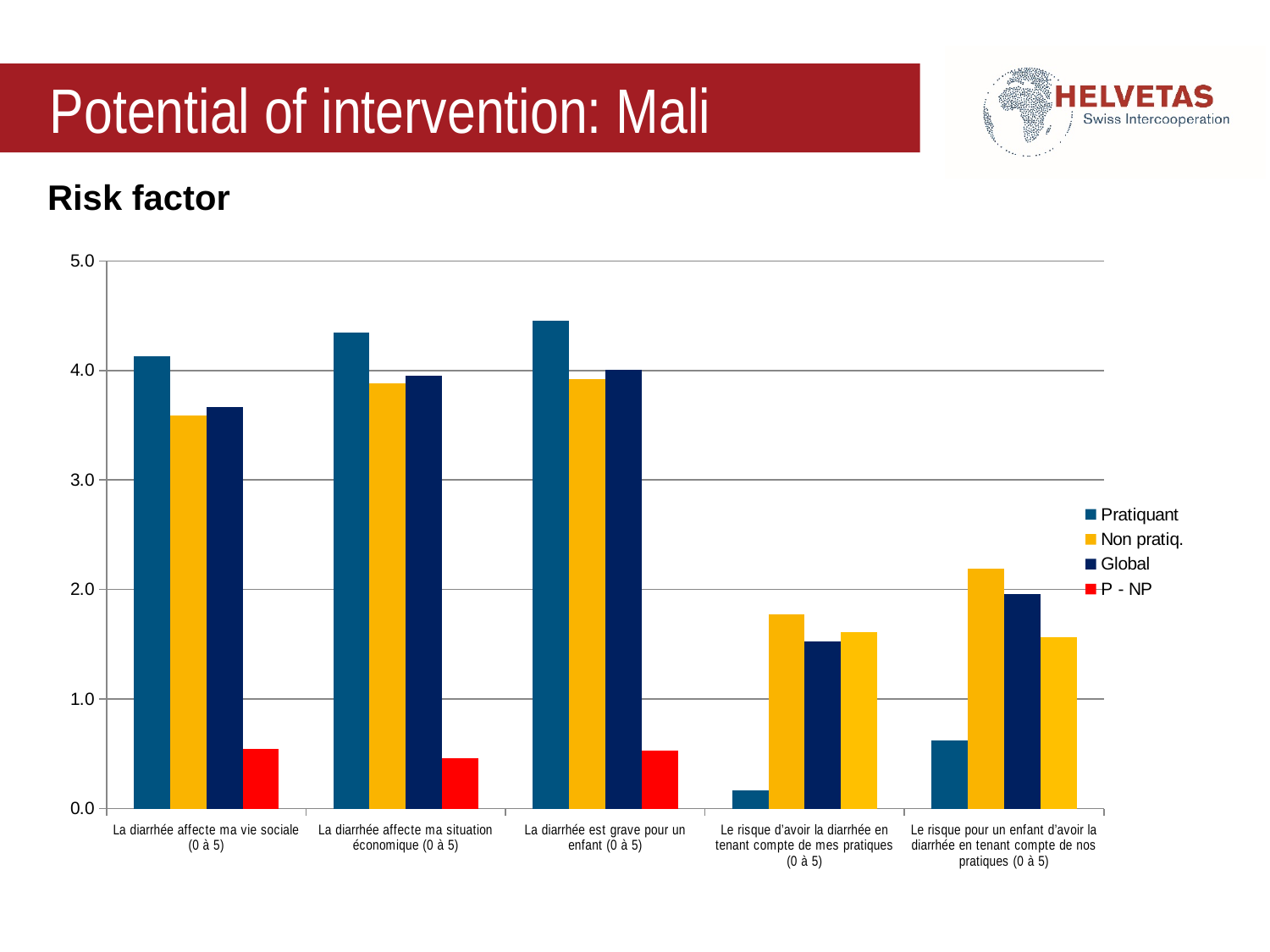
What heading appears above the chart? Risk factor Is the Pratiquant value for "Le risque d'avoir la diarrhée en tenant compte de mes pratiques (0 à 5)" greater or less than 1.0? less For "La diarrhée affecte ma vie sociale (0 à 5)", which is larger: Pratiquant or Non pratiq.? Pratiquant How many categories are shown along the x axis? 5 What colour is used for the P - NP series in the legend? red For "Le risque pour un enfant d'avoir la diarrhée en tenant compte de nos pratiques (0 à 5)", which is larger: Pratiquant or Non pratiq.? Non pratiq. Is the Non pratiq. value for "La diarrhée affecte ma situation économique (0 à 5)" greater or less than 3.0? greater Which category has the lowest Pratiquant value? Le risque d'avoir la diarrhée en tenant compte de mes pratiques (0 à 5) Is the Pratiquant value for "La diarrhée est grave pour un enfant (0 à 5)" greater or less than 4.0? greater What kind of chart is shown on the slide? bar chart How many series does the legend list? 4